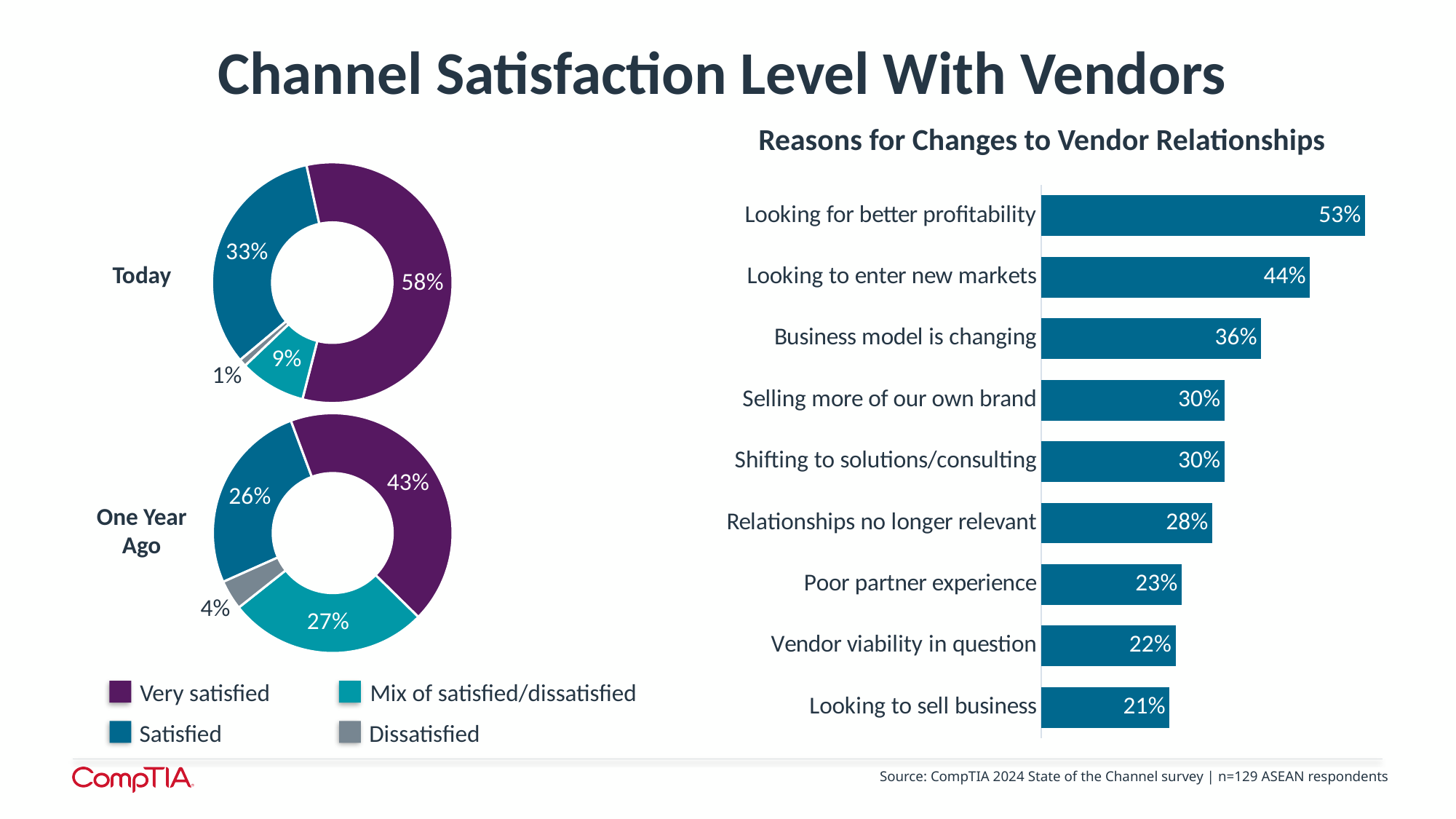
In the 'Reasons for Changes to Vendor Relationships' chart, what is the value for Looking to enter new markets? 44% In the 'Reasons for Changes to Vendor Relationships' chart, what is the difference between Looking for better profitability and Business model is changing? 17 percentage points How many categories does the legend for the donut charts list? 4 What type of chart is 'Reasons for Changes to Vendor Relationships'? Bar chart In the 'Today' donut chart, what percentage is Dissatisfied? 1% How many reasons are listed in the 'Reasons for Changes to Vendor Relationships' chart? 9 In the 'Reasons for Changes to Vendor Relationships' chart, which reason has the lowest value? Looking to sell business In the 'Reasons for Changes to Vendor Relationships' chart, which reason has the highest value? Looking for better profitability In the 'One Year Ago' donut chart, what percentage is Mix of satisfied/dissatisfied? 27% What is the difference between the Very satisfied share Today and One Year Ago? 15 percentage points In the 'Today' donut chart, what percentage is Very satisfied? 58% In the 'One Year Ago' donut chart, which category has the smallest share? Dissatisfied